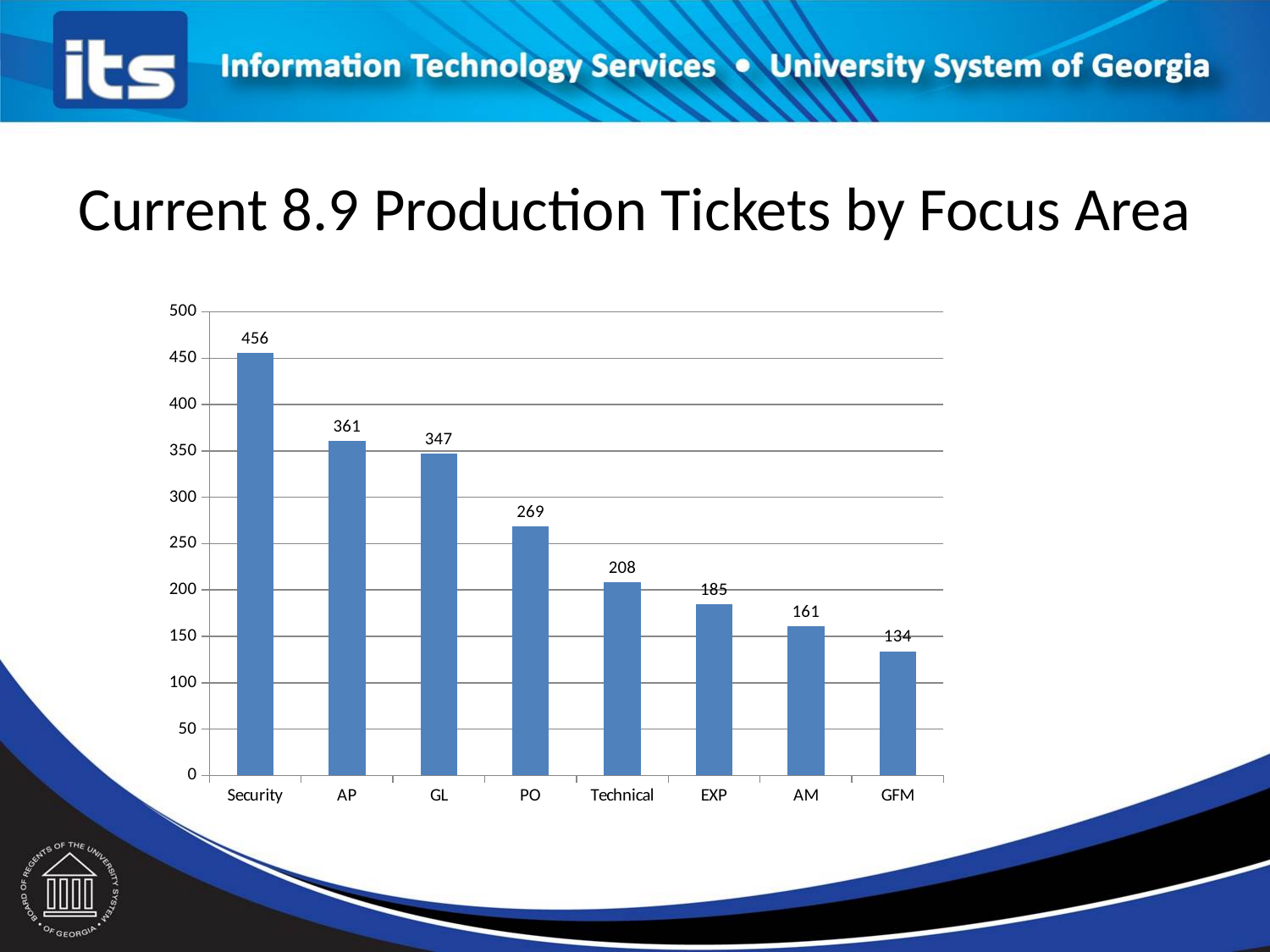
Is the value for AM greater or less than 200? less What kind of chart is shown on the slide? Bar chart Do the values rise or fall from left to right across the focus areas? Fall How many focus areas are shown on the chart? 8 What is the difference between the number of tickets for AP and GL? 14 What is the number of production tickets for Security? 456 Which has more production tickets, Technical or EXP? Technical What is the number of production tickets for GFM? 134 What is the difference between the number of tickets for Security and GFM? 322 Which focus area has the lowest number of production tickets? GFM Which focus area has the highest number of production tickets? Security What is the number of production tickets for PO? 269